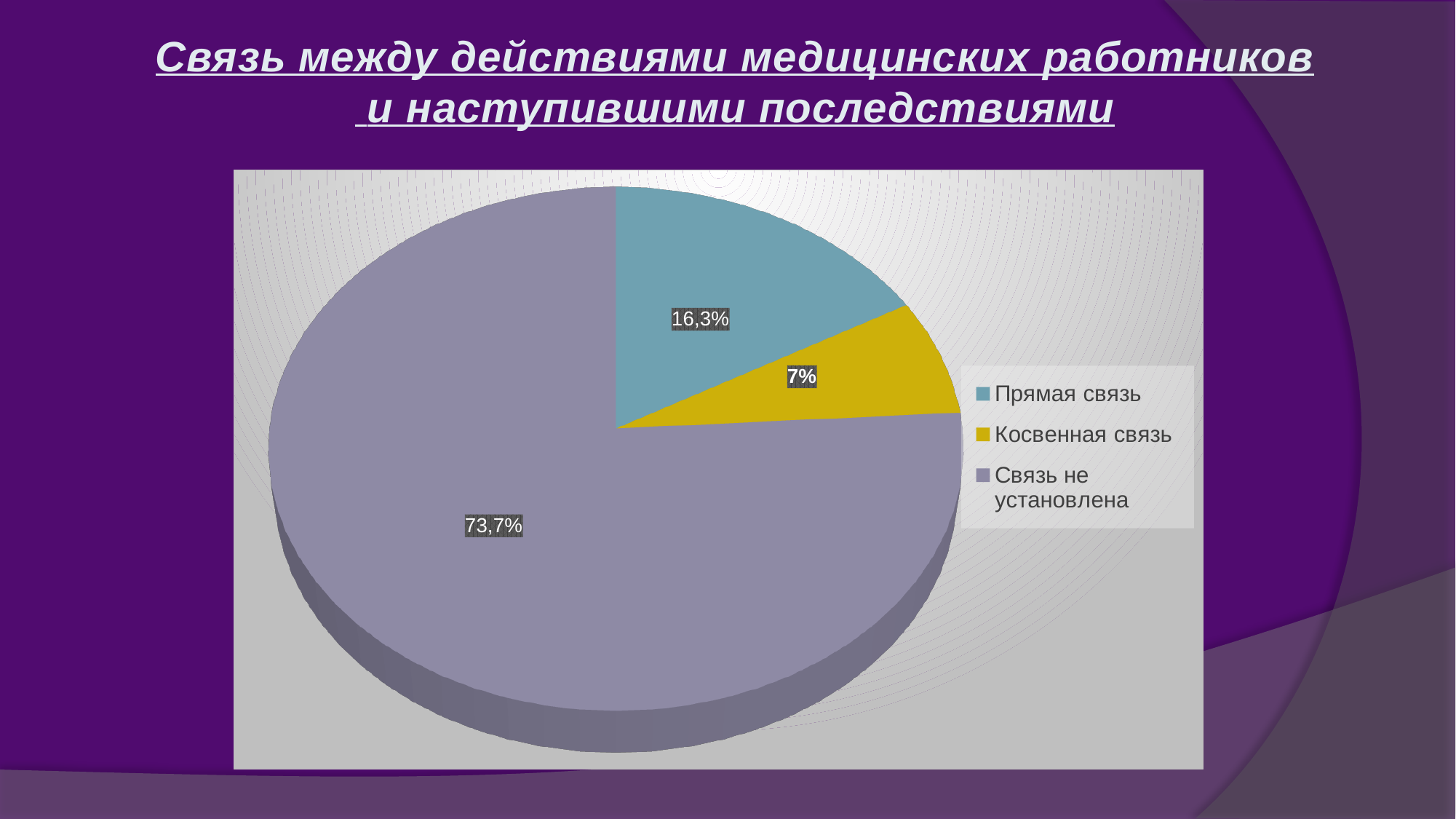
What is the value for Косвенная связь? 7% How many entries does the legend list? 3 Which is larger, Прямая связь or Косвенная связь? Прямая связь Which category has the largest slice? Связь не установлена Which category has the smallest slice? Косвенная связь What colour is the slice for Косвенная связь? yellow What is the difference between Прямая связь and Косвенная связь? 9,3% What is the difference between Связь не установлена and Прямая связь? 57,4% What is the value for Прямая связь? 16,3% What is the value for Связь не установлена? 73,7% How many slices does the pie chart have? 3 What kind of chart is shown on the slide? pie chart